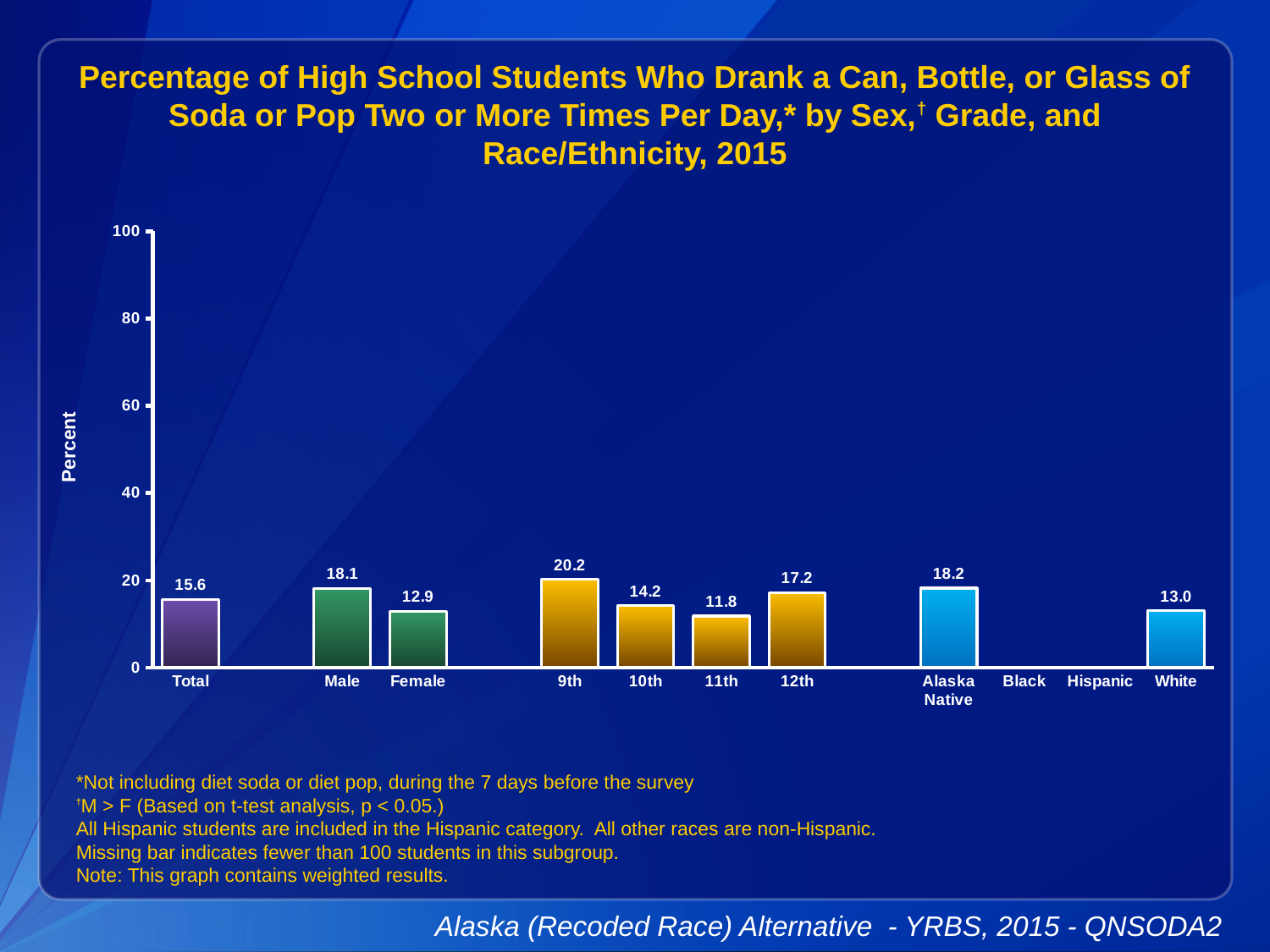
How many categories are labeled on the x axis? 11 What kind of chart is shown? bar chart What is the value for Total? 15.6 Which category has the highest value? 9th Which categories have no bar shown? Black and Hispanic What is the value for Male? 18.1 Which category with a bar has the lowest value? 11th What is the difference between the Male and Female values? 5.2 Which is larger, the value for 10th grade or 12th grade? 12th What is the value for 11th grade? 11.8 What is the value for Alaska Native? 18.2 Is the value for 9th grade greater or less than 20? greater